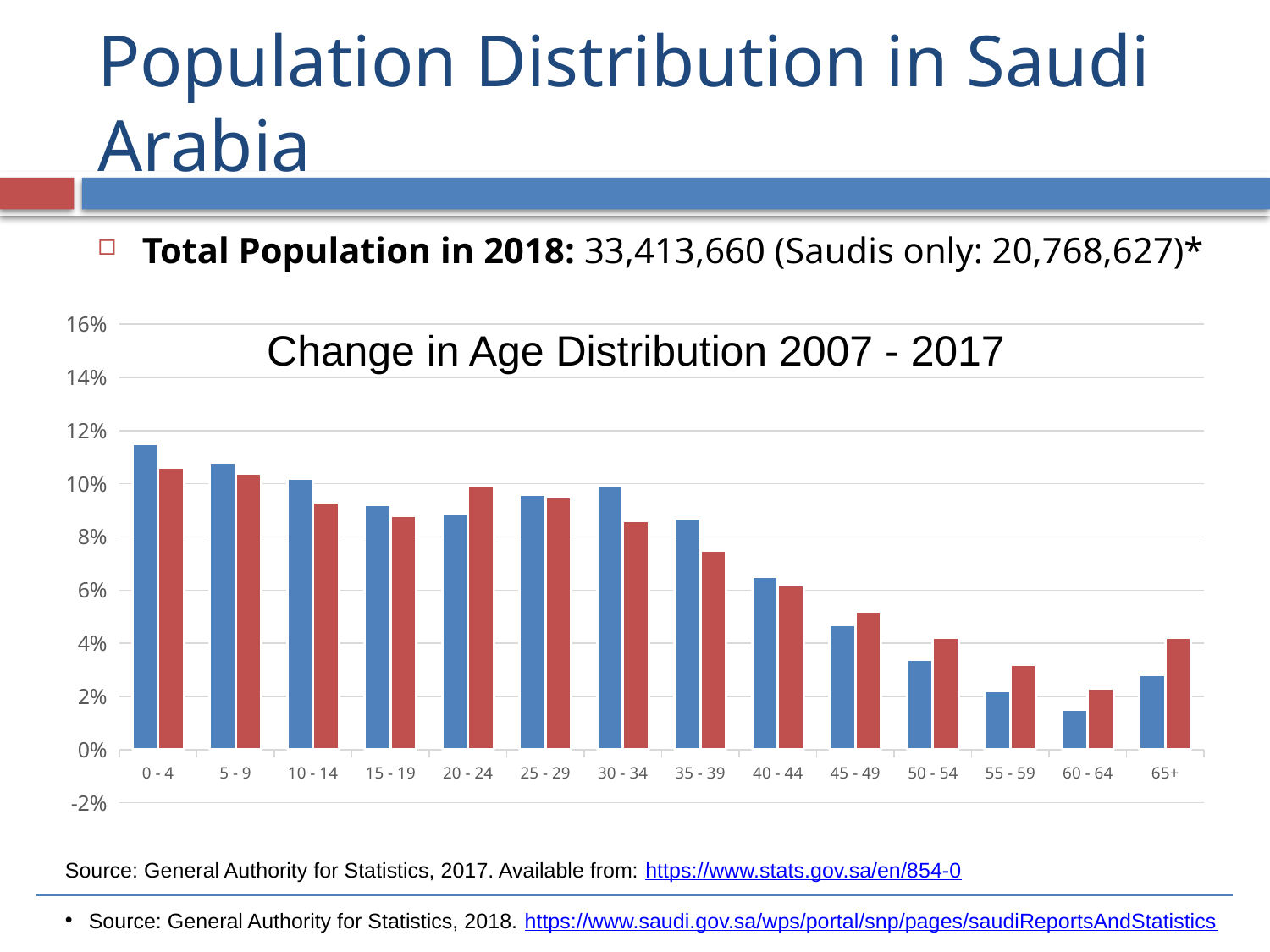
Which age group has the shortest blue bar? 60 - 64 Is the blue bar for the 60 - 64 age group greater or less than 2%? less Which age group has the tallest blue bar? 0 - 4 For the 65+ age group, which bar is taller, the blue one or the red one? red Is the red bar for the 35 - 39 age group greater or less than 8%? less What is the title of the chart? Change in Age Distribution 2007 - 2017 Which age group has the shortest red bar? 60 - 64 What kind of chart is shown on the slide? bar chart Is the blue bar for the 0 - 4 age group greater or less than 10%? greater Do the blue bars generally rise or fall moving from the youngest to the oldest age groups? fall How many age groups are shown on the x axis of the chart? 14 How many series of bars are plotted for each age group? 2